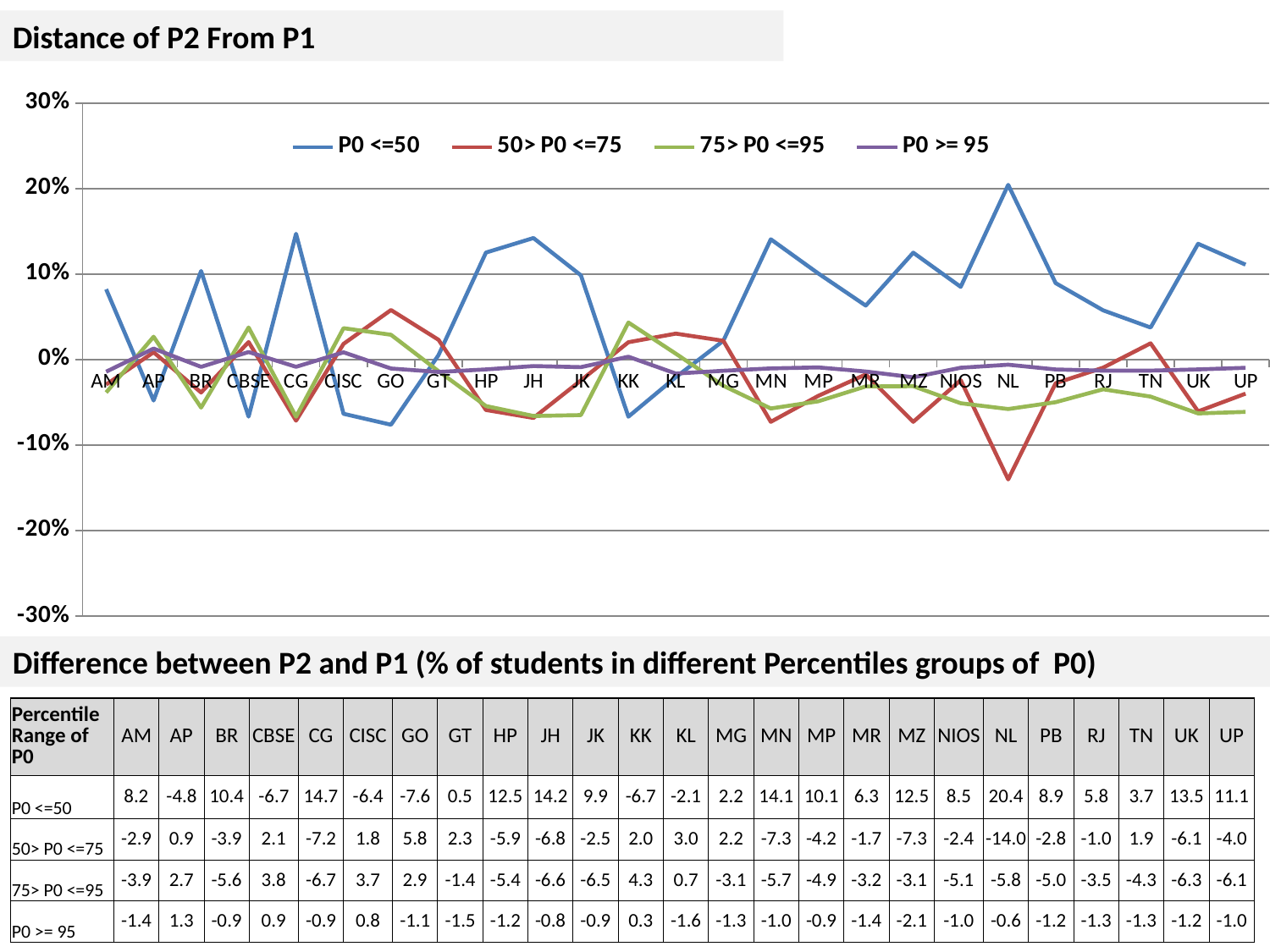
What is the value of the P0 <=50 series for NL? 20.4 How many categories are plotted along the x axis of the chart? 25 What is the difference between the P0 <=50 value for NL and the P0 <=50 value for CG? 5.7 How many series does the legend of the chart list? 4 Which is larger for the P0 <=50 series: the value for HP or the value for JH? JH For which category is the 50> P0 <=75 series lowest? NL What is the value of the 50> P0 <=75 series for GO? 5.8 For which category is the P0 <=50 series highest? NL What is the title of the chart? Distance of P2 From P1 What kind of chart is shown on the slide? line chart What is the value of the P0 >= 95 series for MZ? -2.1 Is the value of the 50> P0 <=75 series for NL greater or less than -10%? less